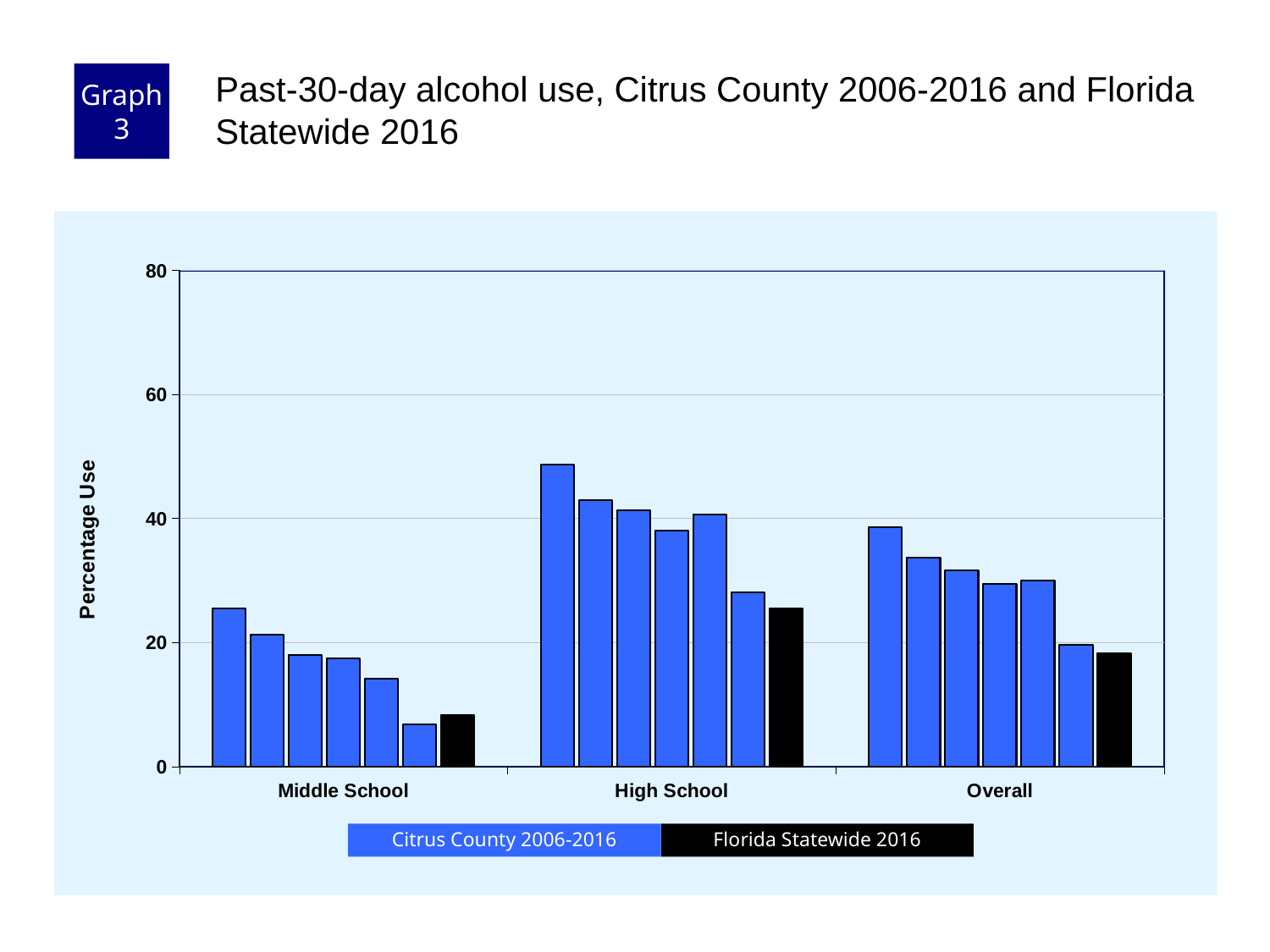
Do the Citrus County 2006-2016 bars within the Middle School group generally rise or fall from left to right? fall Which colour represents Florida Statewide 2016 in the legend? black Which category has the shortest bars overall? Middle School How many series does the legend list? 2 Which is larger, the Florida Statewide 2016 value for High School or for Middle School? High School What kind of chart is shown on the slide? bar chart Which category has the tallest bars overall? High School What is the label of the y axis? Percentage Use Is the Florida Statewide 2016 value for Middle School greater or less than 20? less Is the Florida Statewide 2016 value for High School greater or less than 20? greater How many categories are shown on the x axis? 3 Is the tallest Citrus County bar for High School greater or less than 40? greater